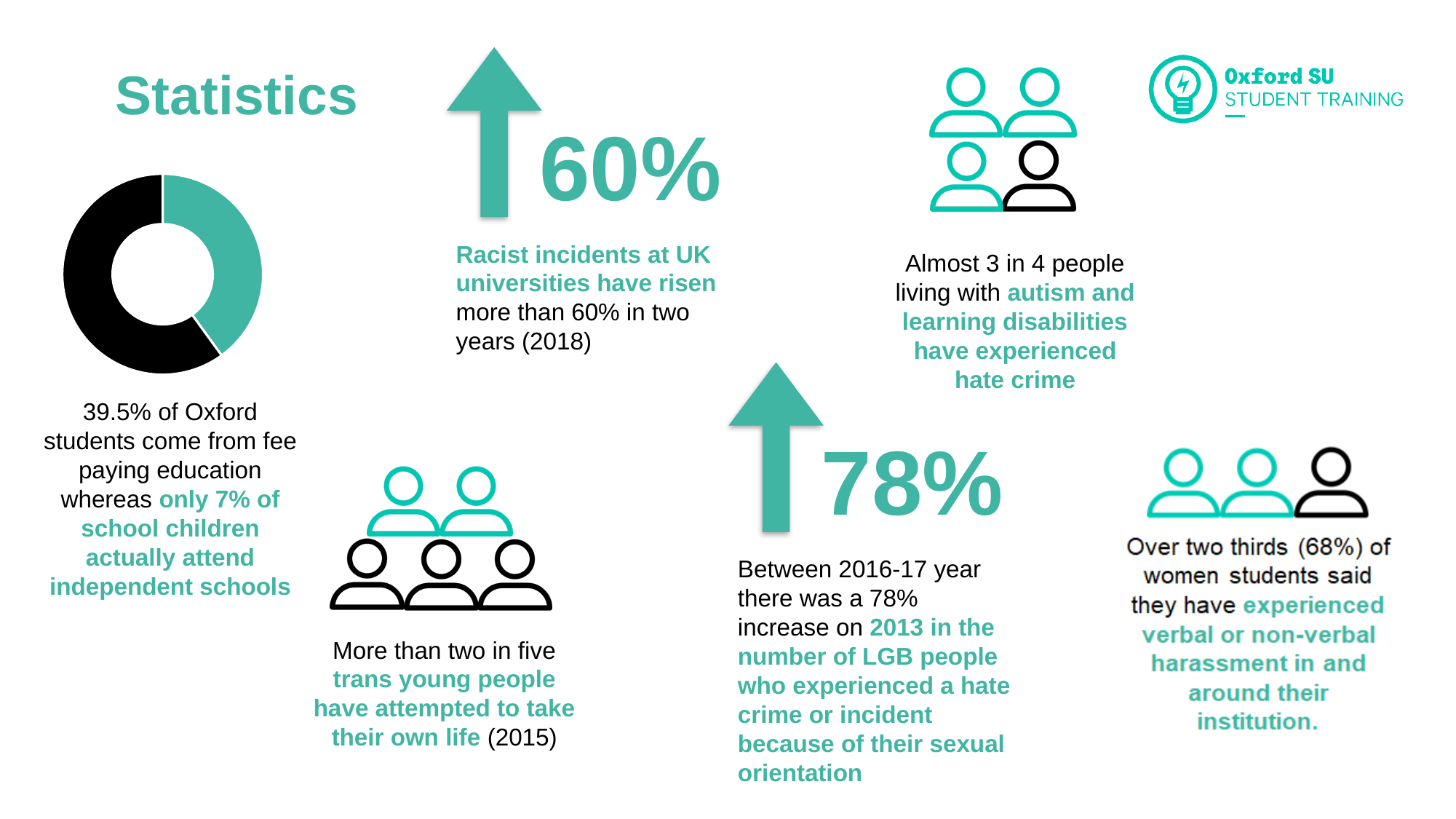
Is the teal slice of the donut chart greater or less than 50% of the whole? less According to the caption under the donut chart, what percentage of school children actually attend independent schools? 7% What kind of chart is shown at the top left of the slide? Donut chart In the donut chart, which slice is larger, the black one or the teal one? The black one Is the black slice of the donut chart greater or less than 50% of the whole? greater According to the caption under the donut chart, what share of Oxford students come from fee paying education? 39.5% What two colours are used for the slices of the donut chart? Black and teal How many slices does the donut chart have? 2 Does the donut chart display any data labels on its slices? No